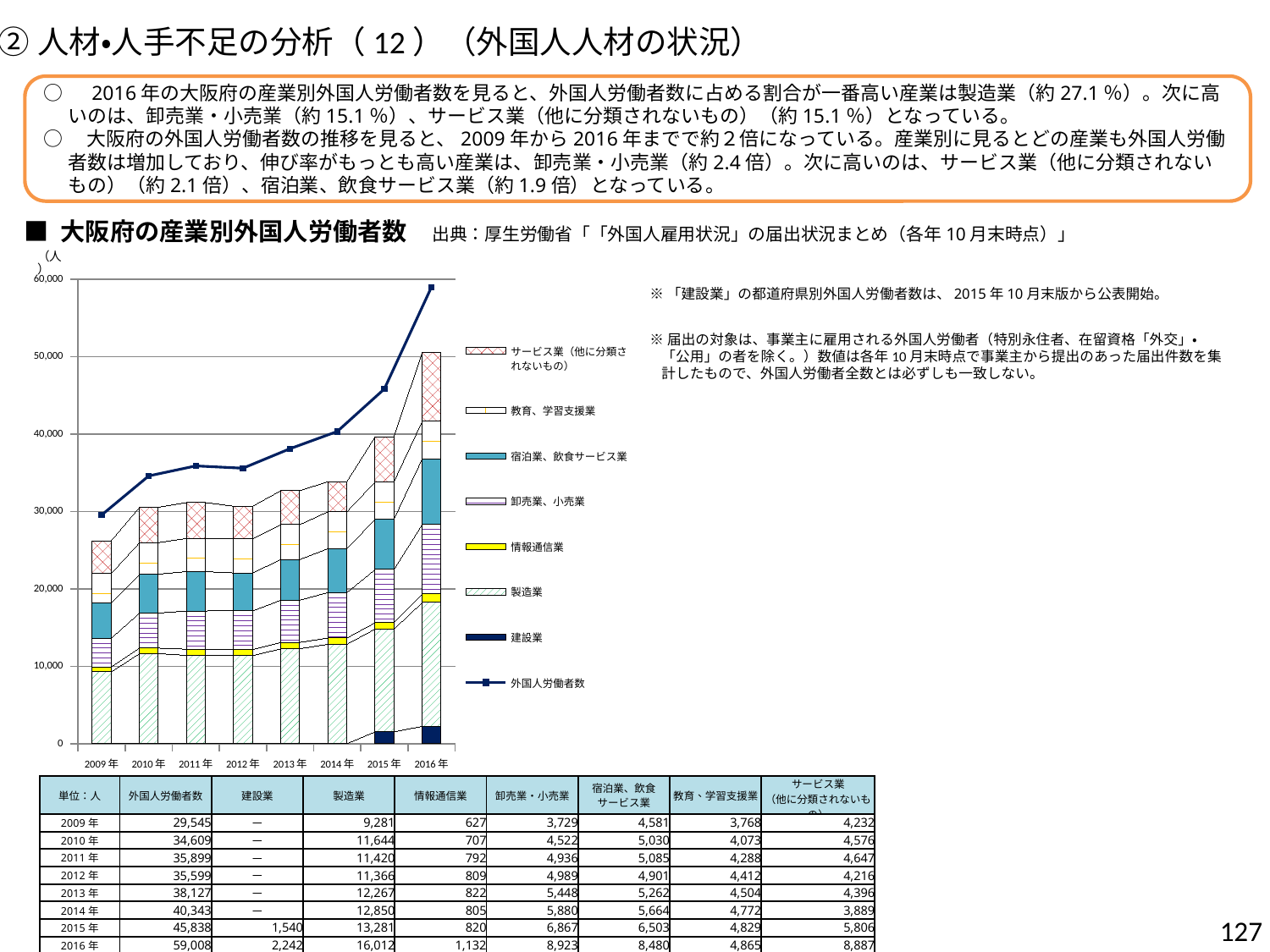
How many entries does the legend of the 大阪府の産業別外国人労働者数 chart list? 8 Using the table values, what is the difference in 外国人労働者数 between 2016年 and 2009年? 29,463 According to the table under the chart, what is the 外国人労働者数 for 2016年? 59,008 In which year is the 外国人労働者数 line lowest in the 大阪府の産業別外国人労働者数 chart? 2009年 According to the table under the chart, what is the 製造業 value for 2016年? 16,012 Does the 外国人労働者数 line in the 大阪府の産業別外国人労働者数 chart rise or fall from 2009年 to 2016年? Rises Is the 外国人労働者数 value for 2016年 greater or less than 50,000? greater Which is larger, the 外国人労働者数 for 2014年 or for 2013年? 2014年 What kind of chart is 大阪府の産業別外国人労働者数? A stacked bar chart with a line Is the 外国人労働者数 value for 2015年 greater or less than 40,000? greater How many years are shown on the x axis of the 大阪府の産業別外国人労働者数 chart? 8 In which year is the 外国人労働者数 line highest in the 大阪府の産業別外国人労働者数 chart? 2016年